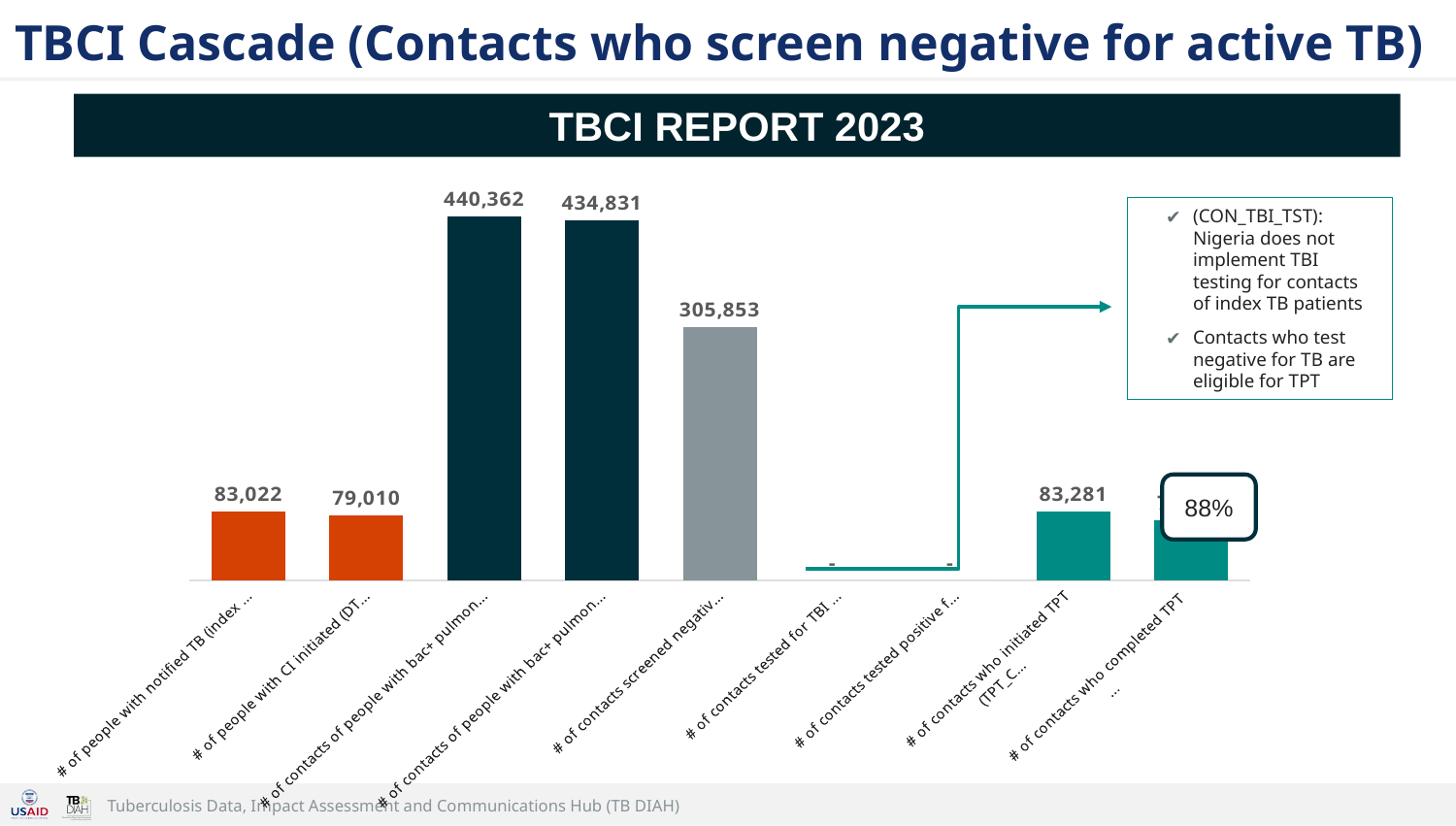
What is the value for '# of contacts who initiated TPT'? 83,281 What percentage is shown in the callout next to the last bar? 88% What is the difference between '# of people with notified TB' and '# of people with CI initiated'? 4,012 How many categories are shown on the x axis of the chart? 9 What is the difference between the third bar (440,362) and the fourth bar (434,831)? 5,531 What kind of chart is shown on the slide? Bar chart What is the value of the fourth bar from the left? 434,831 What is the value of the tallest bar in the chart? 440,362 What is the value for '# of contacts screened negative'? 305,853 What is the value for '# of people with notified TB (index ...)'? 83,022 What is the value for '# of people with CI initiated'? 79,010 Which is larger: '# of contacts screened negative' or '# of contacts who initiated TPT'? # of contacts screened negative